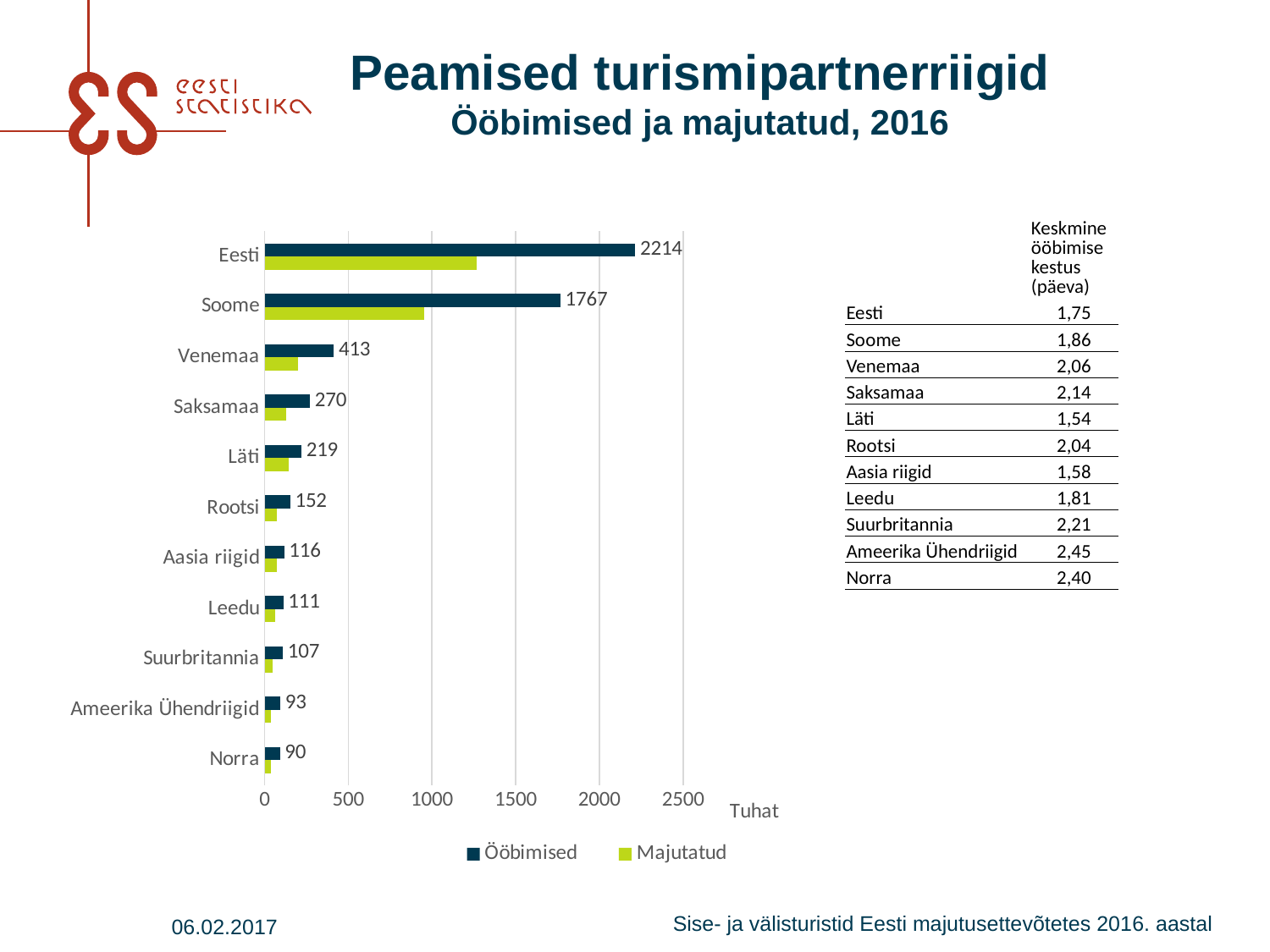
Which category has the highest Ööbimised value? Eesti Is the Majutatud value for Venemaa greater or less than 500? less What is the Ööbimised value for Norra? 90 Which has a larger Ööbimised value, Saksamaa or Läti? Saksamaa How many series does the legend list? 2 What is the Ööbimised value for Venemaa? 413 What kind of chart is shown on the slide? bar chart Is the Majutatud value for Eesti greater or less than 1000? greater How many categories are shown on the chart? 11 What is the difference between the Ööbimised values for Eesti and Soome? 447 What is the Ööbimised value for Soome? 1767 Which category has the lowest Ööbimised value? Norra